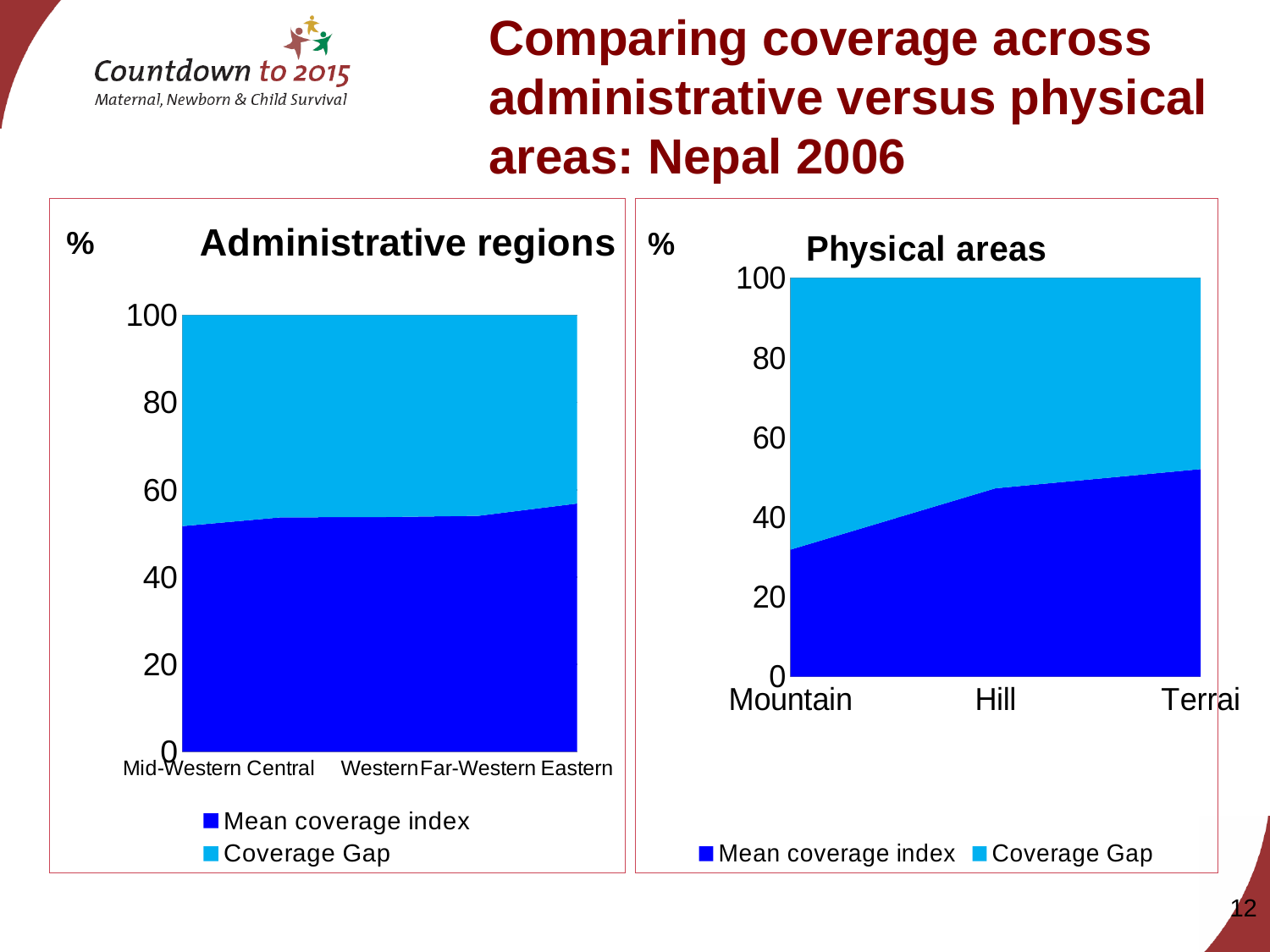
In the 'Physical areas' chart, is the Mean coverage index for Mountain greater or less than 40? less In the 'Physical areas' chart, which physical area has the highest Mean coverage index? Terrai In the 'Physical areas' chart, which physical area has the lowest Mean coverage index? Mountain In the 'Administrative regions' chart, is the Mean coverage index for Mid-Western greater or less than 40? greater In the 'Physical areas' chart, is the Mean coverage index for Terrai greater or less than 60? less What kind of chart is the 'Physical areas' chart? area chart How many categories are shown on the x axis of the 'Physical areas' chart? 3 What are the two legend entries of the 'Administrative regions' chart? Mean coverage index, Coverage Gap How many series does the legend of the 'Physical areas' chart list? 2 How many categories are shown on the x axis of the 'Administrative regions' chart? 5 In the 'Physical areas' chart, does the Mean coverage index rise or fall from Mountain to Terrai? rise